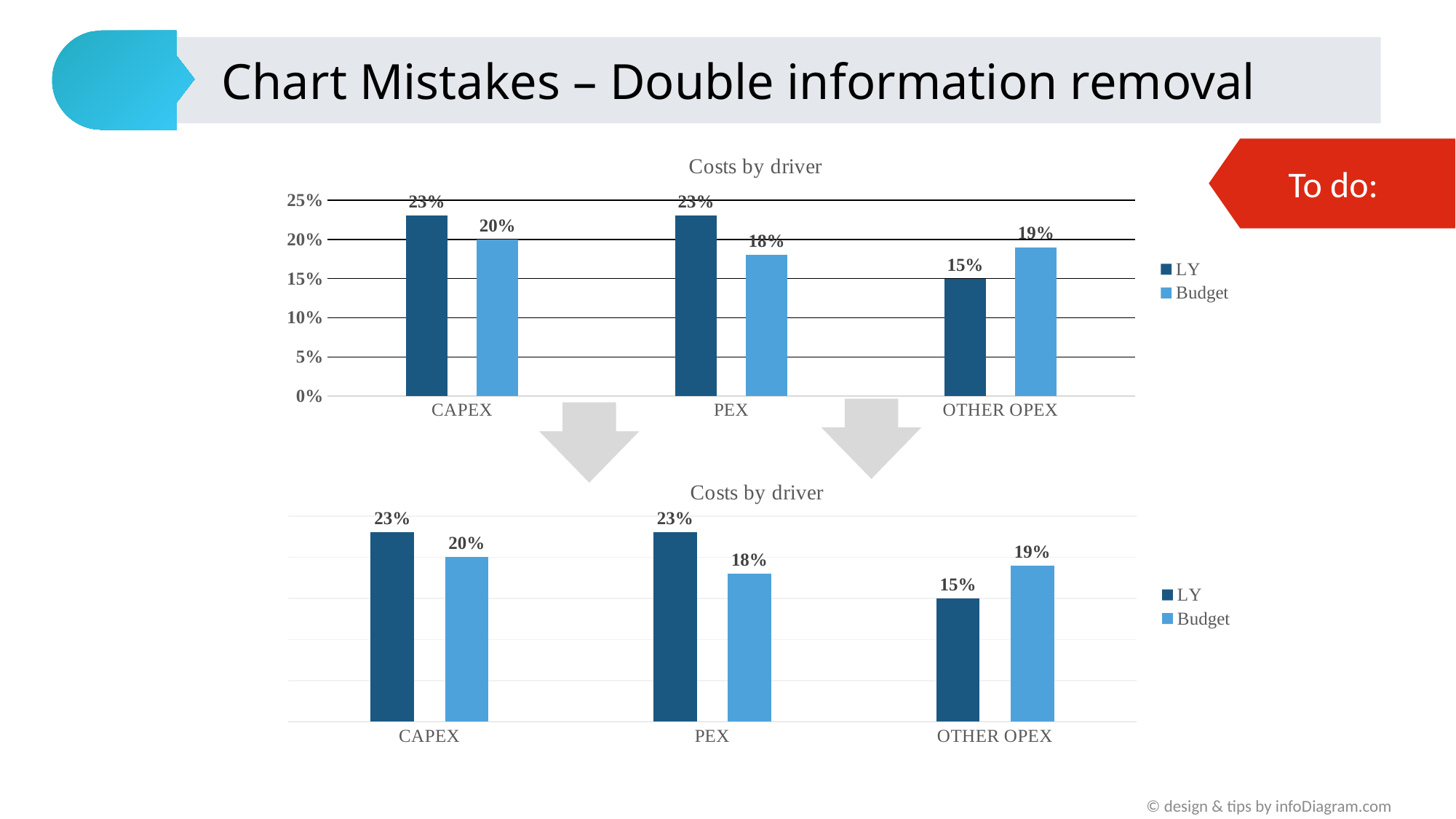
In the top chart, what is the LY value for CAPEX? 23% In the bottom chart, what is the Budget value for OTHER OPEX? 19% What type of chart is the bottom chart? Bar chart In the top chart, what is the Budget value for PEX? 18% In the top chart, which category has the lowest LY value? OTHER OPEX In the bottom chart, which category has the highest Budget value? CAPEX In the bottom chart, what is the LY value for OTHER OPEX? 15% In the bottom chart, which is larger for OTHER OPEX, LY or Budget? Budget In the top chart, is the Budget value for CAPEX greater or less than 15%? greater In the top chart, what is the difference between the LY and Budget values for PEX? 5% How many series does the legend of the top chart list? 2 How many categories are shown on the x axis of the bottom chart? 3